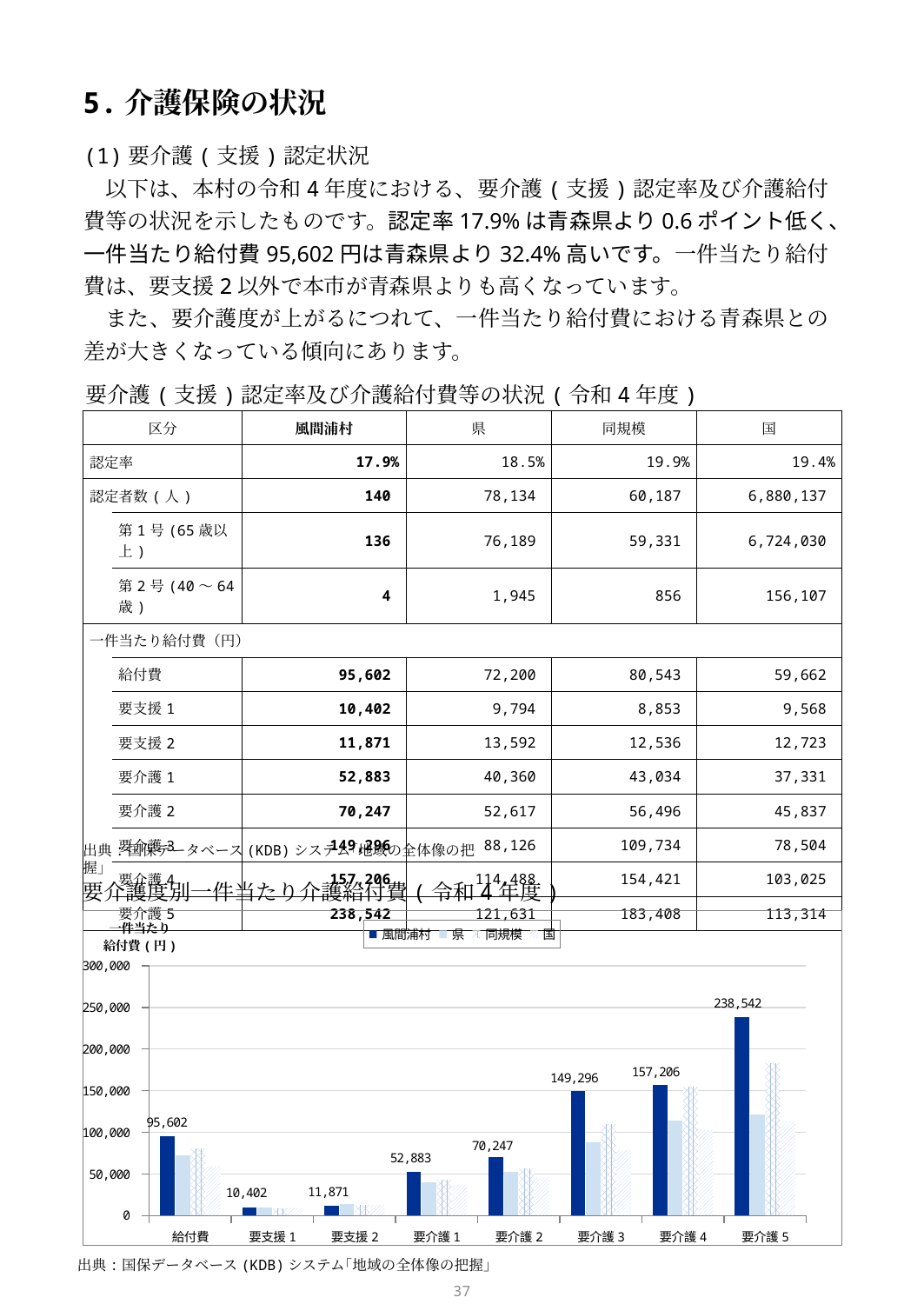
In the chart, what is the value for 風間浦村 in the 要介護5 category? 238,542 In the chart, is the value for 国 in the 給付費 category greater or less than 100,000? less How many categories are shown along the x axis of the chart? 8 In the chart, which category has the lowest value for 風間浦村? 要支援1 What kind of chart is shown on the slide? bar chart In the chart, what is the value for 風間浦村 in the 要介護3 category? 149,296 In the chart, what is the difference between the 風間浦村 values for 要介護5 and 要介護4? 81,336 In the chart, is the value for 県 in the 要介護5 category greater or less than 150,000? less How many series does the chart legend list? 4 In the chart, what is the value for 風間浦村 in the 要支援1 category? 10,402 In the chart, is the 風間浦村 value for 要介護2 larger than the 風間浦村 value for 要介護1? Yes In the chart, which category has the highest value for 風間浦村? 要介護5